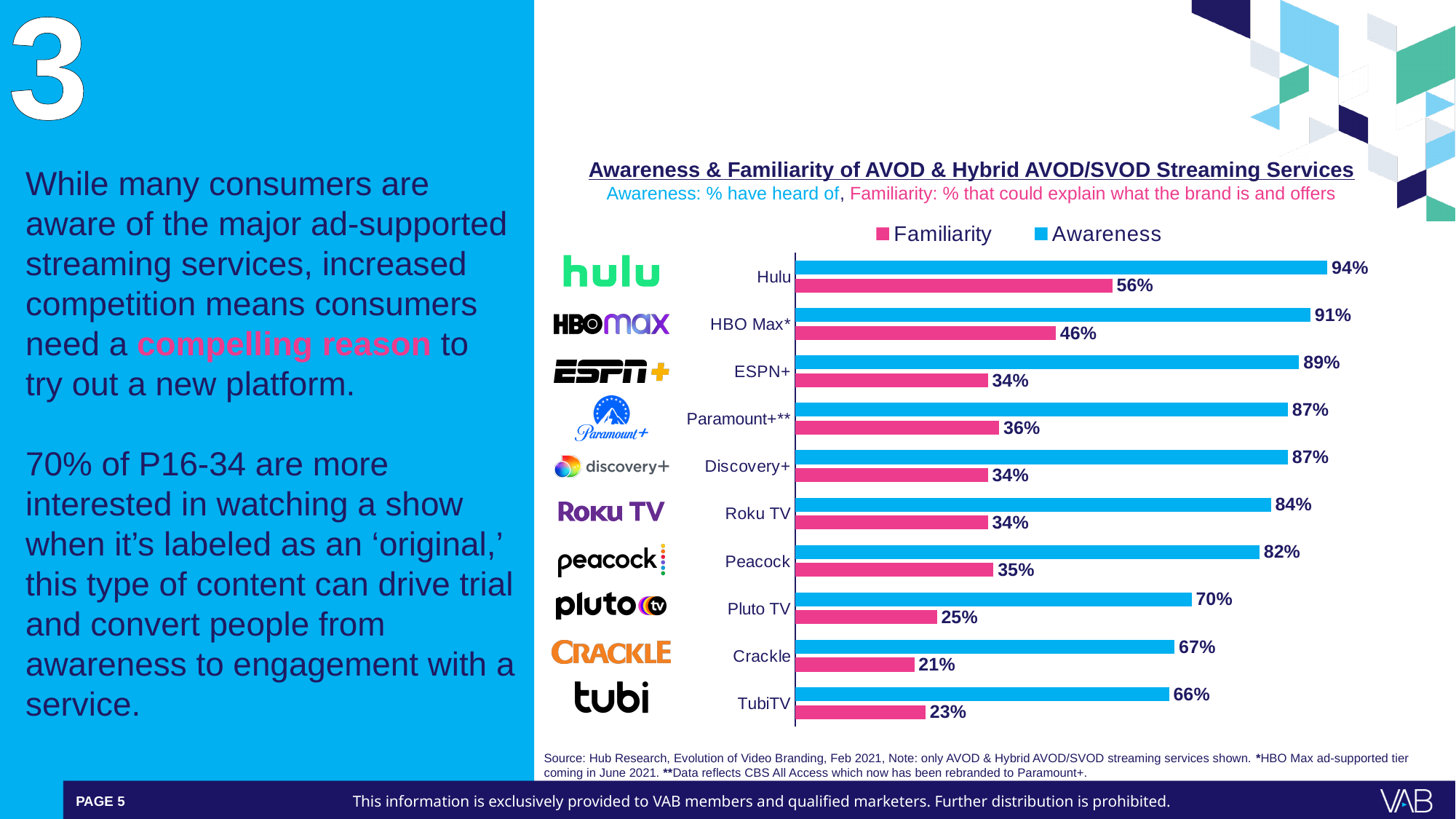
What is the Awareness value for Hulu? 94% Which is larger, the Awareness value for Peacock or the Awareness value for Pluto TV? Peacock What kind of chart is shown on the slide? Bar chart What is the Familiarity value for Pluto TV? 25% Which service has the highest Awareness value? Hulu Which service has the lowest Familiarity value? Crackle What is the Familiarity value for HBO Max*? 46% How many streaming services are shown on the chart? 10 What is the difference between the Awareness and Familiarity values for Hulu? 38% Which colour represents the Familiarity series in the chart? Pink What is the difference between the Awareness values for ESPN+ and TubiTV? 23% How many series does the legend list? 2